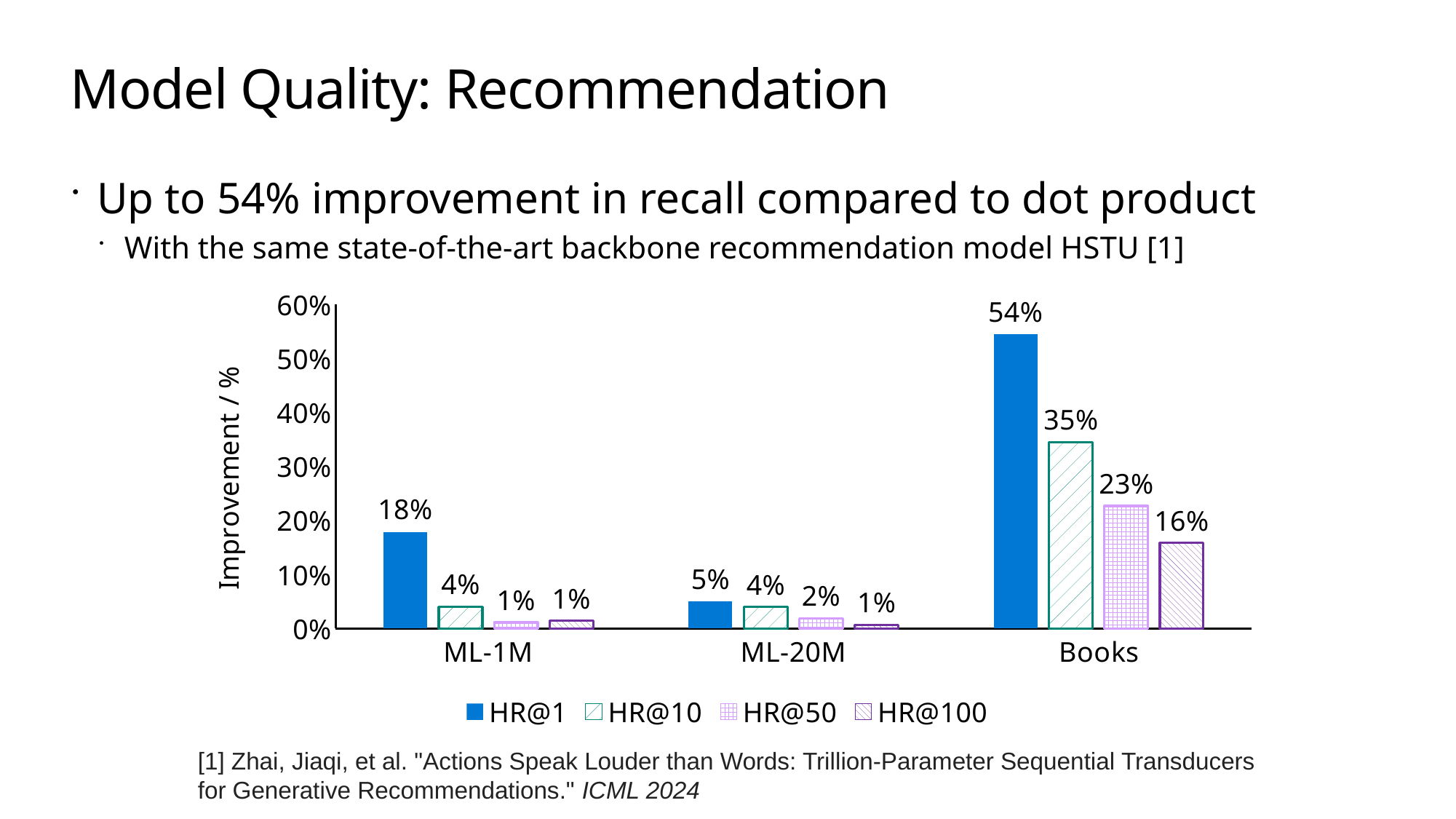
Which is larger for ML-1M: the HR@1 improvement or the HR@10 improvement? HR@1 What is the HR@1 improvement for the Books dataset? 54% Is the HR@1 improvement for Books greater or less than 50%? greater What is the HR@50 improvement for ML-20M? 2% What is the HR@10 improvement for ML-1M? 4% Which dataset has the highest HR@1 improvement? Books What kind of chart is shown on the slide? Bar chart What is the HR@100 improvement for Books? 16% What is the difference between the HR@1 and HR@10 improvements for Books? 19% Which dataset has the lowest HR@1 improvement? ML-20M How many datasets are shown on the x axis? 3 How many series does the legend list? 4